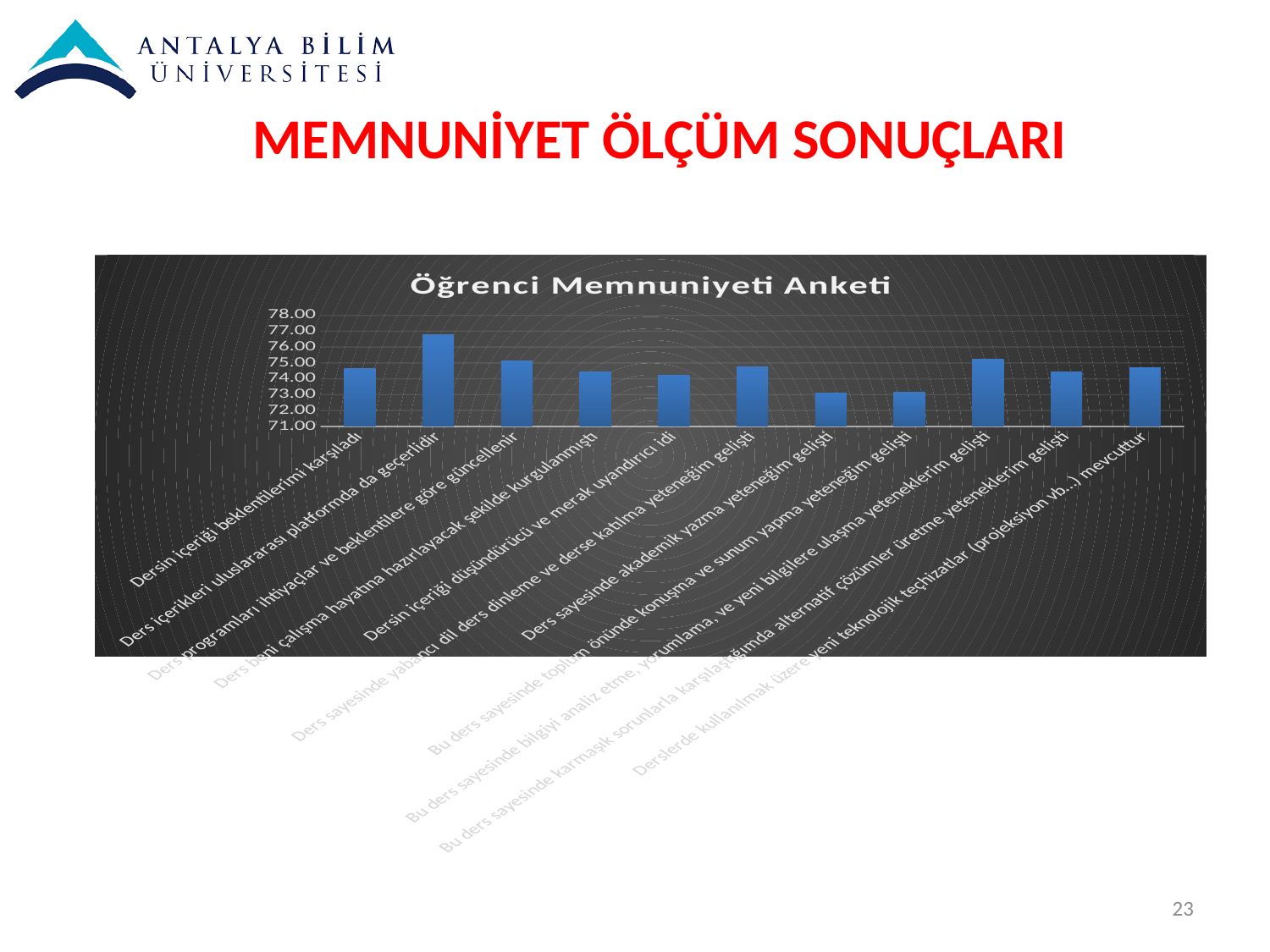
Is the value for "Ders sayesinde akademik yazma yeteneğim gelişti" greater or less than 74.00? less Which has a larger value: "Dersin içeriği beklentilerimi karşıladı" or "Bu ders sayesinde toplum önünde konuşma ve sunum yapma yeteneğim gelişti"? Dersin içeriği beklentilerimi karşıladı Is the value for "Bu ders sayesinde toplum önünde konuşma ve sunum yapma yeteneğim gelişti" greater or less than 74.00? less What type of chart is shown on the slide? Bar chart How many bars (categories) does the chart show? 11 Is the value for "Dersin içeriği beklentilerimi karşıladı" greater or less than 74.00? greater Which has a larger value: "Ders içerikleri uluslararası platformda da geçerlidir" or "Ders sayesinde akademik yazma yeteneğim gelişti"? Ders içerikleri uluslararası platformda da geçerlidir What is the lowest value shown on the vertical axis of the chart? 71.00 Which category has the highest value in the chart? Ders içerikleri uluslararası platformda da geçerlidir What is the title of the chart? Öğrenci Memnuniyeti Anketi